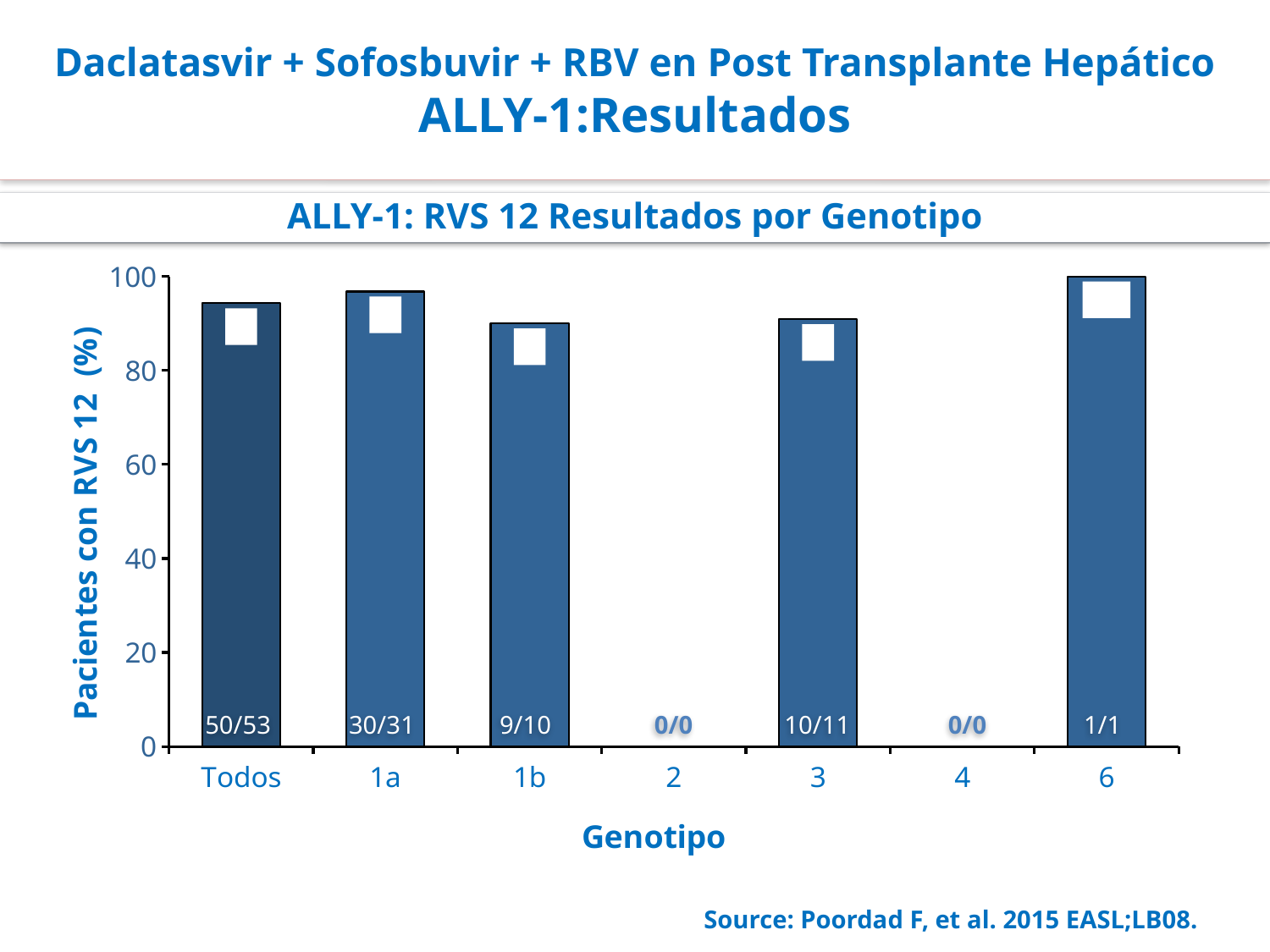
What is the label printed on the bar for the 'Todos' category? 50/53 Which genotype category has the highest bar? 6 What is the label printed for genotype 2? 0/0 What is the label printed on the bar for genotype 1b? 9/10 What is the label printed for genotype 6? 1/1 How many genotype categories are shown on the x axis? 7 What is the title of the chart? ALLY-1: RVS 12 Resultados por Genotipo Is the value for 'Todos' greater or less than 80? greater What kind of chart is shown on the slide? bar chart What is the label printed for genotype 3? 10/11 What is the label printed on the bar for genotype 1a? 30/31 Which bar is taller, genotype 1a or genotype 1b? 1a